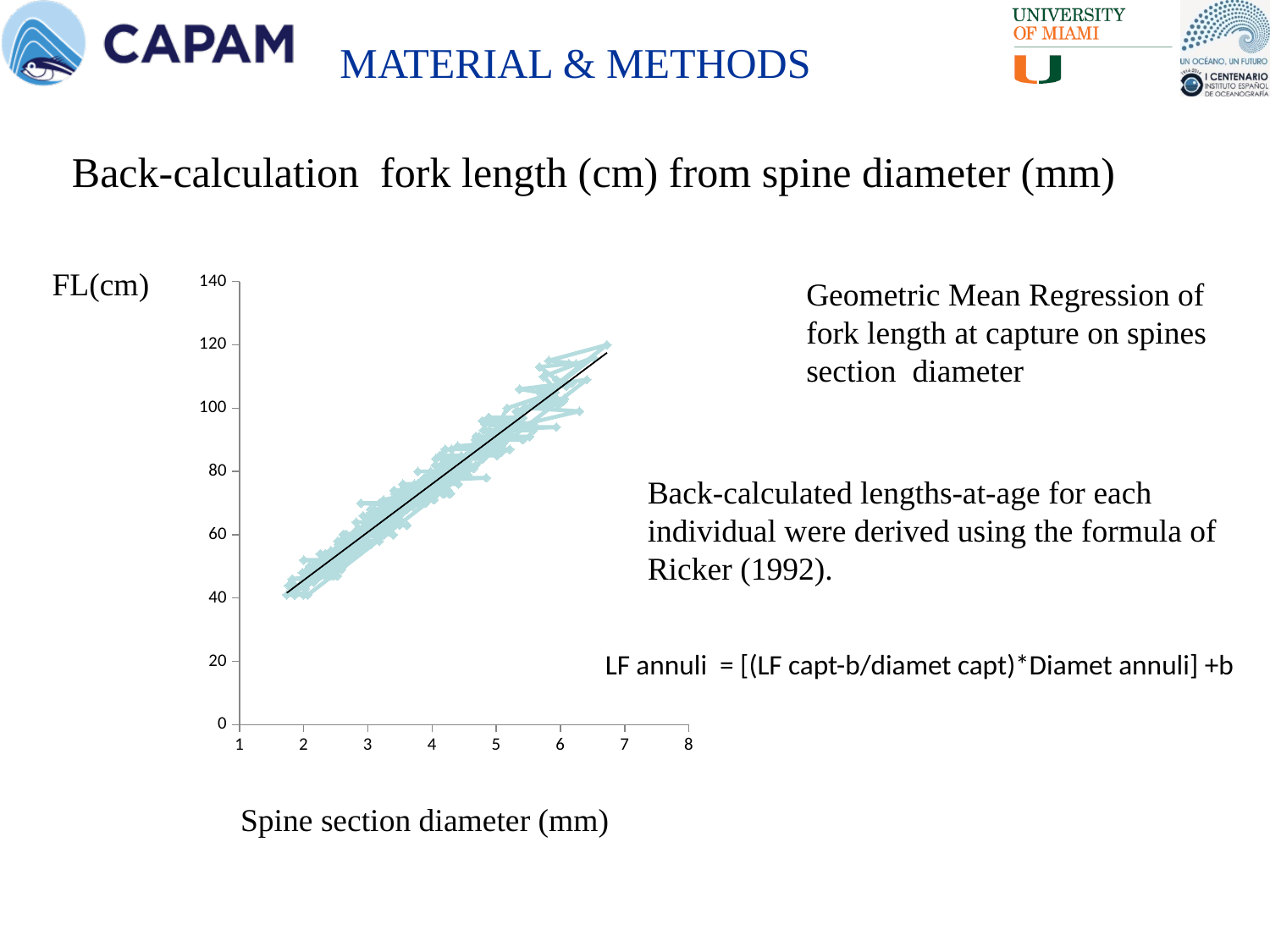
What is the label of the y axis of the chart? FL(cm) Are the fork length values plotted at a spine section diameter of 4 mm greater or less than 40? greater Do the fork length values rise or fall as spine section diameter increases along the x axis? rise Are the fork length values plotted at a spine section diameter of 2 mm greater or less than 60? less What is the label of the x axis of the chart? Spine section diameter (mm) What kind of chart is shown on the slide? scatter plot What is the highest value shown on the y axis of the chart? 140 Are the fork length values plotted at a spine section diameter of 6 mm greater or less than 80? greater